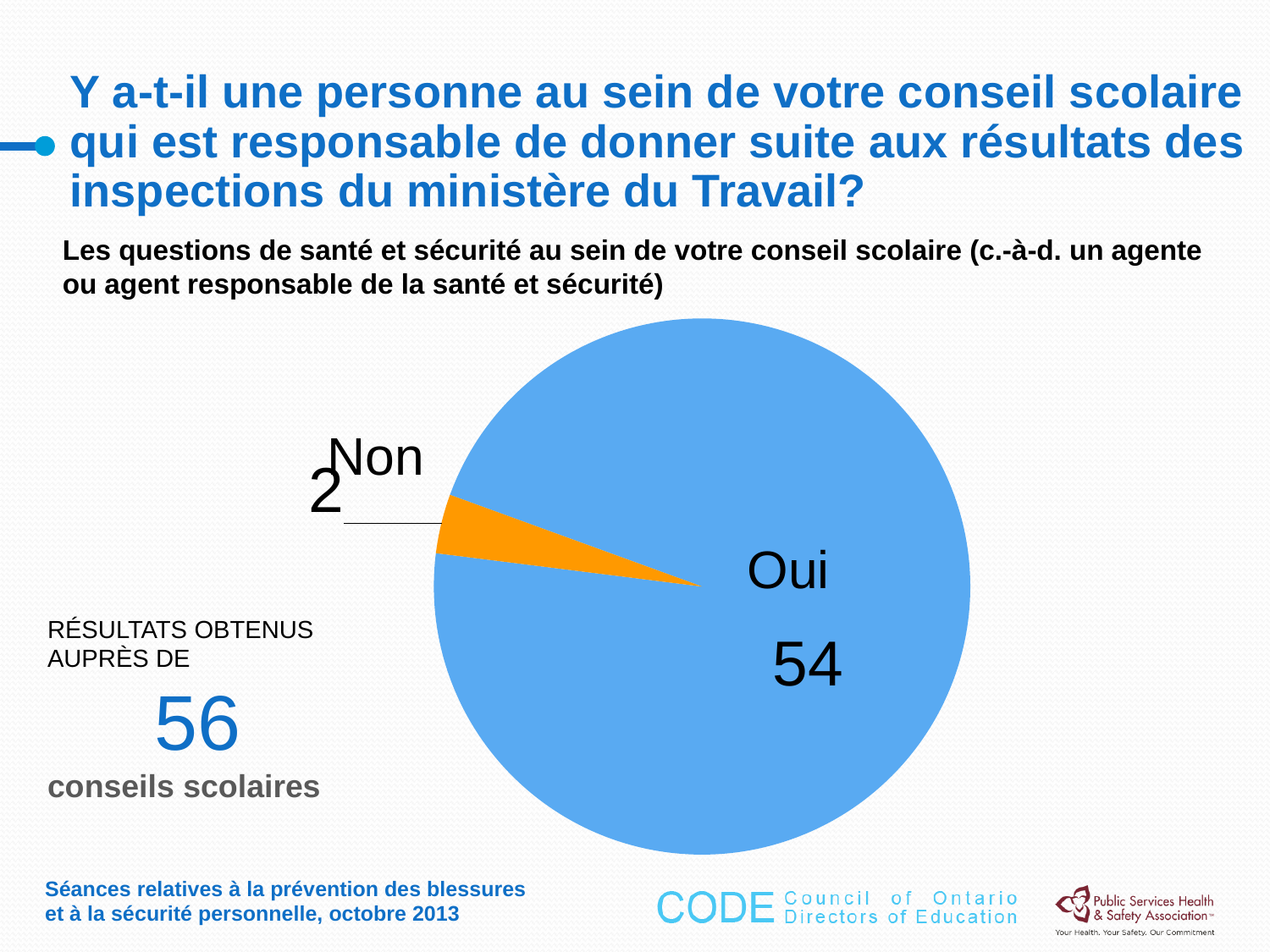
What is the value for the "Non" slice in the pie chart? 2 What kind of chart is shown on the slide? Pie chart What is the total of the two slices in the pie chart? 56 What share of the pie chart does the "Oui" slice represent, as a percentage? 96.4% What colour is the "Non" slice in the pie chart? Orange Which slice of the pie chart is the smallest? Non What is the value for the "Oui" slice in the pie chart? 54 How many slices does the pie chart have? 2 How many school boards (conseils scolaires) do the results on the slide come from? 56 Which slice of the pie chart is the largest? Oui Which is larger in the pie chart, "Oui" or "Non"? Oui What is the difference between the "Oui" and "Non" values in the pie chart? 52